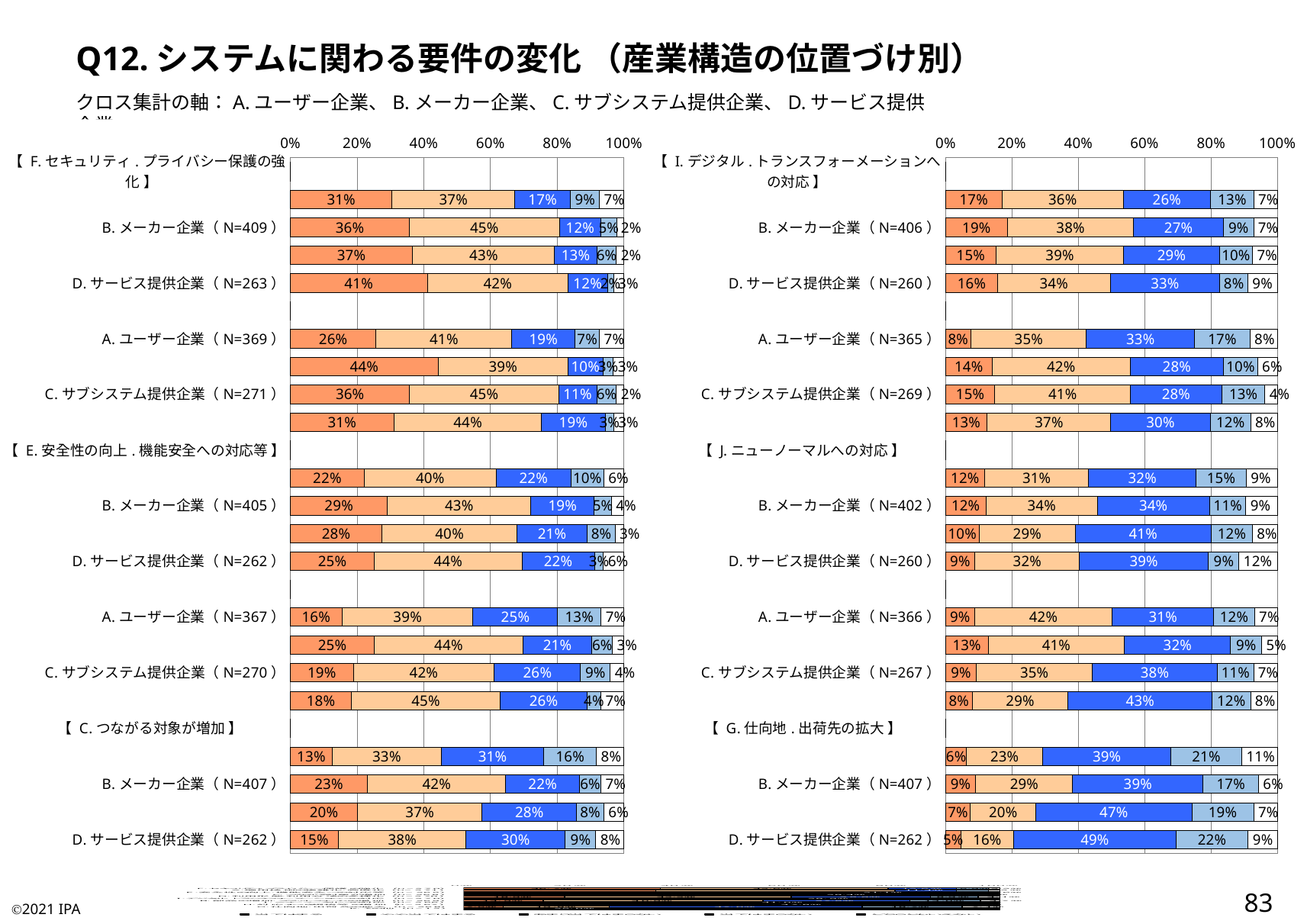
What is the title of the slide? Q12. システムに関わる要件の変化（産業構造の位置づけ別） How many requirement sections (headings in 【 】) are shown in the left chart? 3 In the left chart, under 【F. セキュリティ.プライバシー保護の強化】, what is the difference between the leftmost (dark orange) segment values for D. サービス提供企業 (N=263) and A. ユーザー企業 (N=369)? 15% What is the N value shown for C. サブシステム提供企業 under 【J. ニューノーマルへの対応】 in the right chart? 267 In the left chart, under 【C. つながる対象が増加】, which has the larger leftmost (dark orange) segment: B. メーカー企業 (N=407) or D. サービス提供企業 (N=262)? B. メーカー企業 (N=407) In the left chart, under 【E. 安全性の向上.機能安全への対応等】, what is the value of the leftmost (dark orange) segment for A. ユーザー企業 (N=367)? 16% In the right chart, under 【G. 仕向地.出荷先の拡大】, what is the value of the third (dark blue) segment for D. サービス提供企業 (N=262)? 49% In the right chart, under 【J. ニューノーマルへの対応】, which has the larger third (dark blue) segment: B. メーカー企業 (N=402) or D. サービス提供企業 (N=260)? D. サービス提供企業 (N=260) What kind of chart is used on this slide? stacked bar chart In the left chart, under 【F. セキュリティ.プライバシー保護の強化】, what is the value of the leftmost (dark orange) segment for D. サービス提供企業 (N=263)? 41% In the right chart, under 【I. デジタル.トランスフォーメーションへの対応】, what is the difference between the leftmost (dark orange) segment values for B. メーカー企業 (N=406) and A. ユーザー企業 (N=365)? 11% In the right chart, under 【I. デジタル.トランスフォーメーションへの対応】, what is the value of the second (light orange) segment for C. サブシステム提供企業 (N=269)? 41%